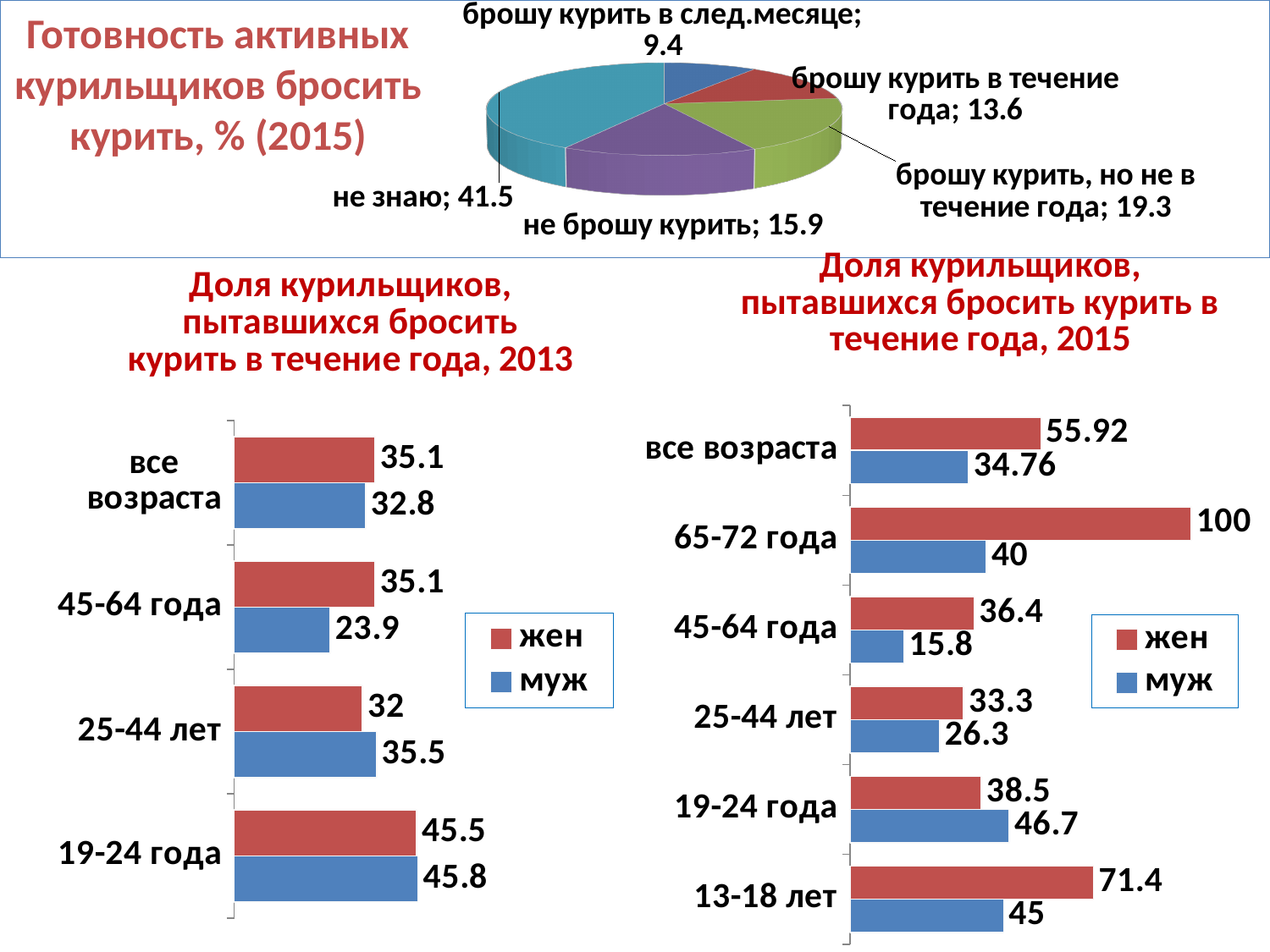
In the chart 'Доля курильщиков, пытавшихся бросить курить в течение года, 2015', which age group has the lowest value for 'муж'? 45-64 года In the chart 'Доля курильщиков, пытавшихся бросить курить в течение года, 2013', what is the value for 'муж' in the '45-64 года' group? 23.9 In the pie chart 'Готовность активных курильщиков бросить курить, % (2015)', how many slices are there? 5 In the chart 'Доля курильщиков, пытавшихся бросить курить в течение года, 2013', which age group has the highest value for 'жен'? 19-24 года In the chart 'Доля курильщиков, пытавшихся бросить курить в течение года, 2015', which is larger for '19-24 года': 'жен' or 'муж'? муж In the pie chart 'Готовность активных курильщиков бросить курить, % (2015)', what is the difference between 'брошу курить, но не в течение года' and 'брошу курить в течение года'? 5.7 What type of chart is 'Доля курильщиков, пытавшихся бросить курить в течение года, 2013'? bar chart In the pie chart 'Готовность активных курильщиков бросить курить, % (2015)', what is the value for 'не знаю'? 41.5 In the pie chart 'Готовность активных курильщиков бросить курить, % (2015)', which category has the smallest value? брошу курить в след.месяце How many series does the legend list in the chart 'Доля курильщиков, пытавшихся бросить курить в течение года, 2015'? 2 In the chart 'Доля курильщиков, пытавшихся бросить курить в течение года, 2013', what is the difference between 'жен' and 'муж' for '45-64 года'? 11.2 In the chart 'Доля курильщиков, пытавшихся бросить курить в течение года, 2015', what is the value for 'жен' in the '65-72 года' group? 100